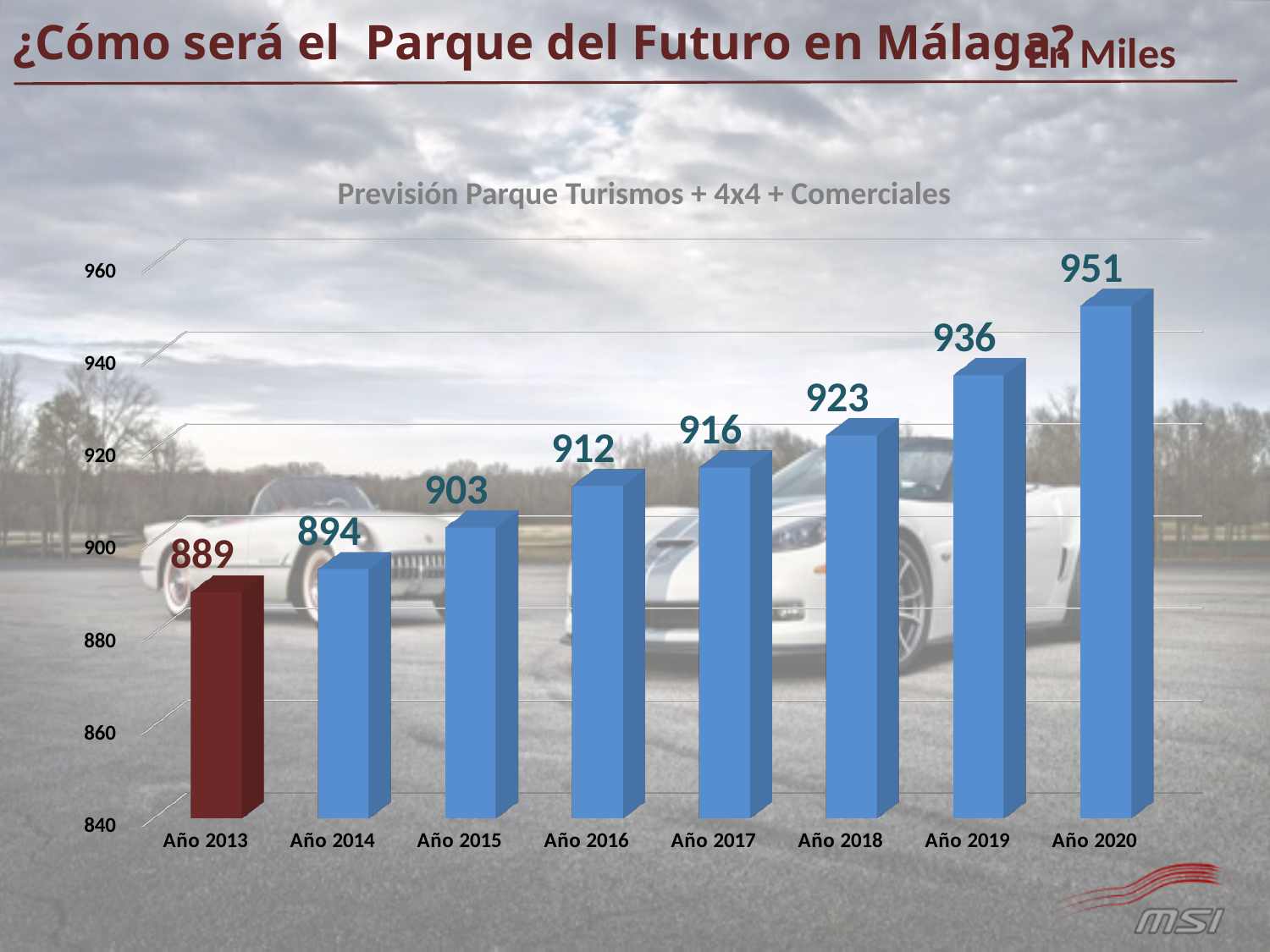
What is the difference between the values for Año 2016 and Año 2015? 9 What is the difference between the values for Año 2020 and Año 2013? 62 What is the value for Año 2020? 951 How many years are shown on the chart? 8 Is the value for Año 2014 greater or less than 900? less What kind of chart is shown on the slide? bar chart Which is larger, the value for Año 2018 or the value for Año 2019? Año 2019 Which year has the highest value? Año 2020 What is the value for Año 2013? 889 What is the value for Año 2017? 916 Do the values rise or fall from Año 2013 to Año 2020? rise Which year has the lowest value? Año 2013